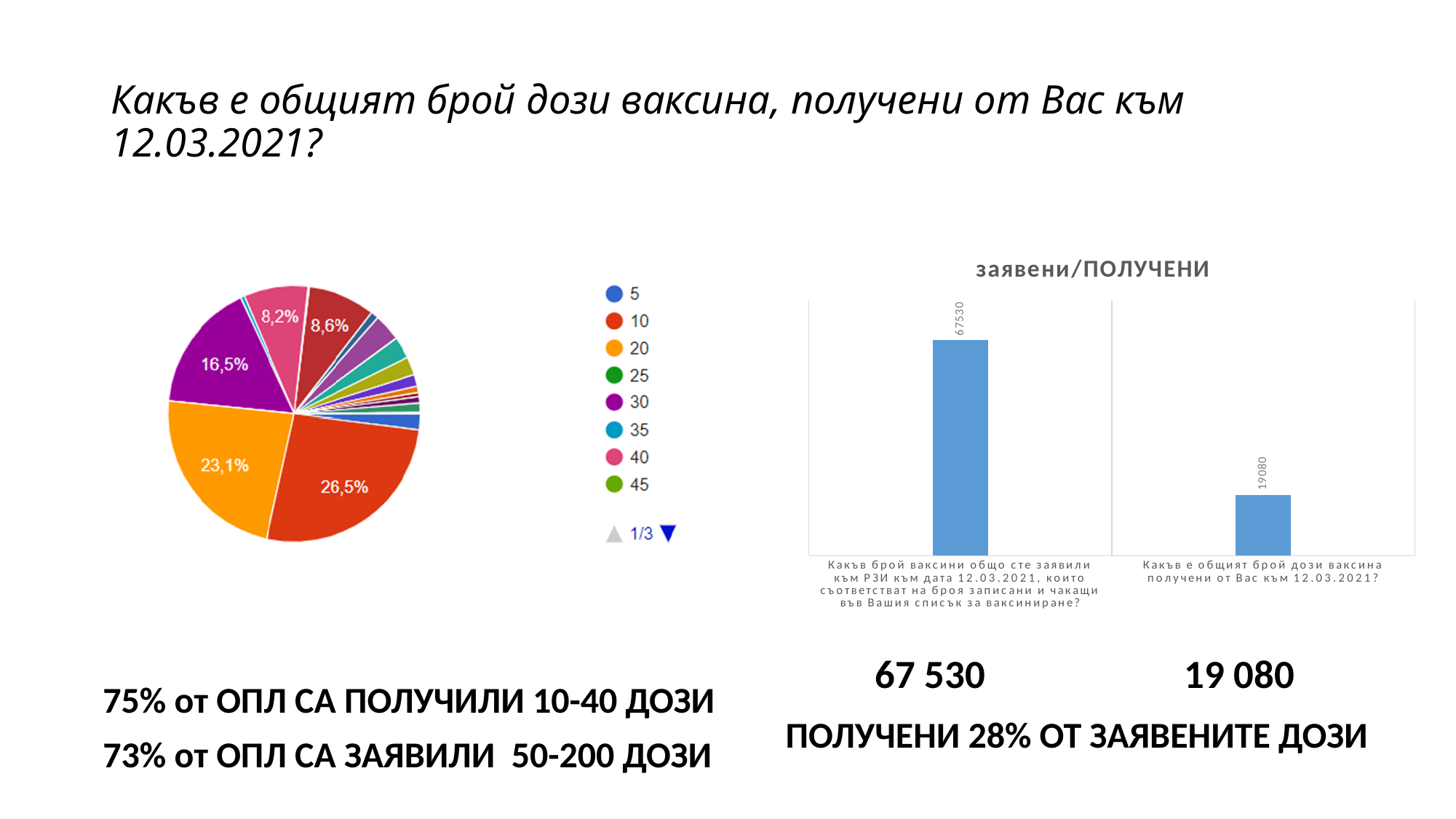
How many bars are plotted on the bar chart titled "заявени/ПОЛУЧЕНИ"? 2 What type of chart is the chart on the left of the slide? Pie chart On the pie chart on the left, what share does the orange slice (legend entry 20) have? 23,1% On the pie chart on the left, what share does the purple slice (legend entry 30) have? 16,5% On the bar chart titled "заявени/ПОЛУЧЕНИ", what is the value of the bar for the total number of vaccine doses received (получени) as of 12.03.2021? 19080 On the bar chart titled "заявени/ПОЛУЧЕНИ", what is the difference between the requested doses and the received doses? 48450 How many entries are listed in the visible legend of the pie chart on the left? 8 What type of chart is the chart on the right titled "заявени/ПОЛУЧЕНИ"? Bar chart On the pie chart on the left, what is the largest labelled slice's share? 26,5% On the pie chart on the left, which is larger: the red slice (legend entry 10) or the orange slice (legend entry 20)? The red slice (10), 26,5% On the bar chart titled "заявени/ПОЛУЧЕНИ", which bar is taller: the requested doses or the received doses? Requested doses (67530) On the bar chart titled "заявени/ПОЛУЧЕНИ", what is the value of the bar for the number of vaccines requested (заявени) to РЗИ as of 12.03.2021? 67530